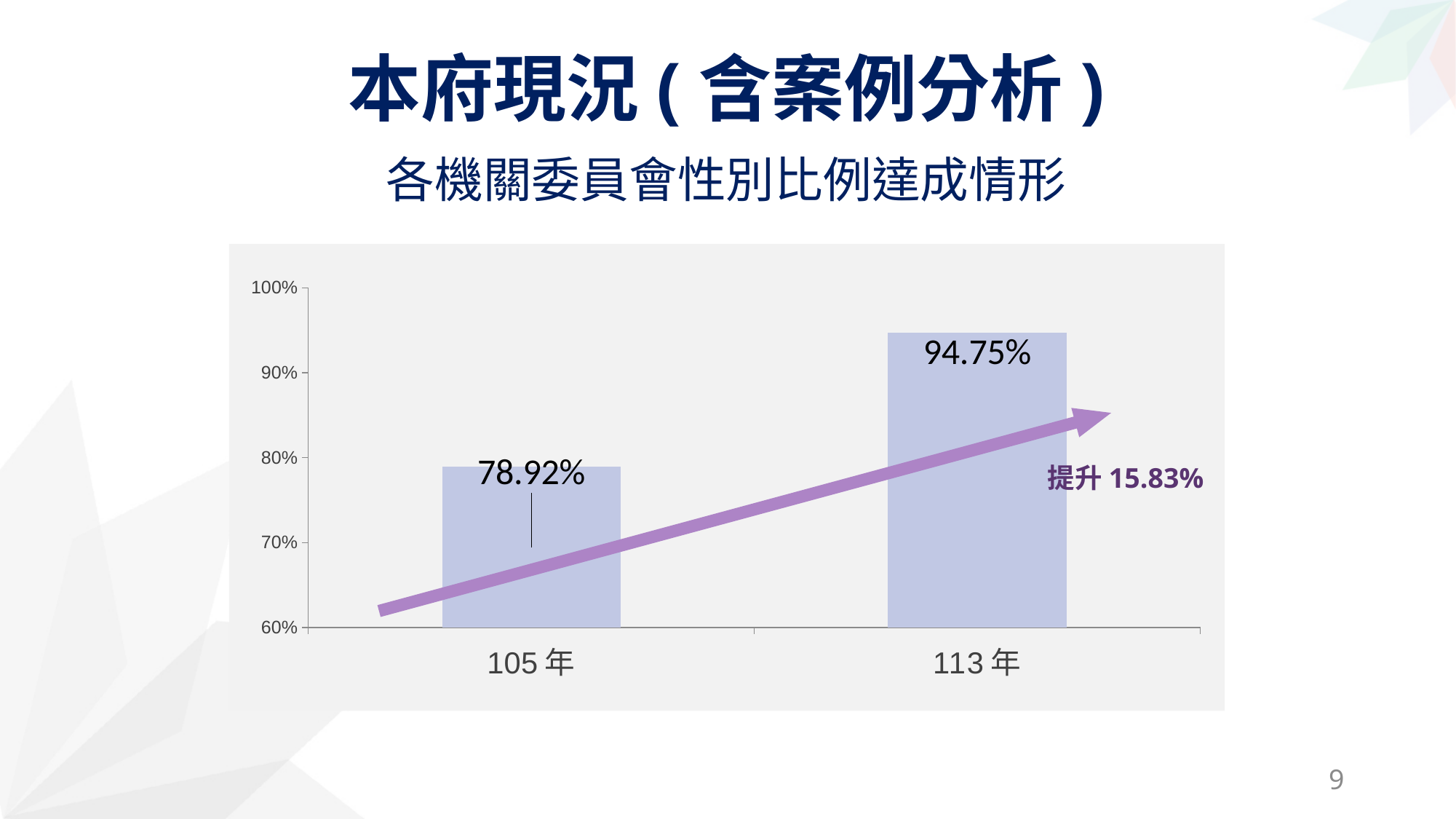
What is the value for 113 年? 94.75% What increase does the annotation next to the arrow state? 提升 15.83% What is the value for 105 年? 78.92% Which category has the highest value? 113 年 How many categories are shown on the x axis? 2 Which category has the lowest value? 105 年 Is the value for 105 年 greater or less than 80%? less What is the difference between the values for 113 年 and 105 年? 15.83% Is the value for 113 年 greater or less than 90%? greater Which is larger, the value for 105 年 or the value for 113 年? 113 年 What kind of chart is shown on the slide? bar chart Do the values rise or fall from 105 年 to 113 年? rise